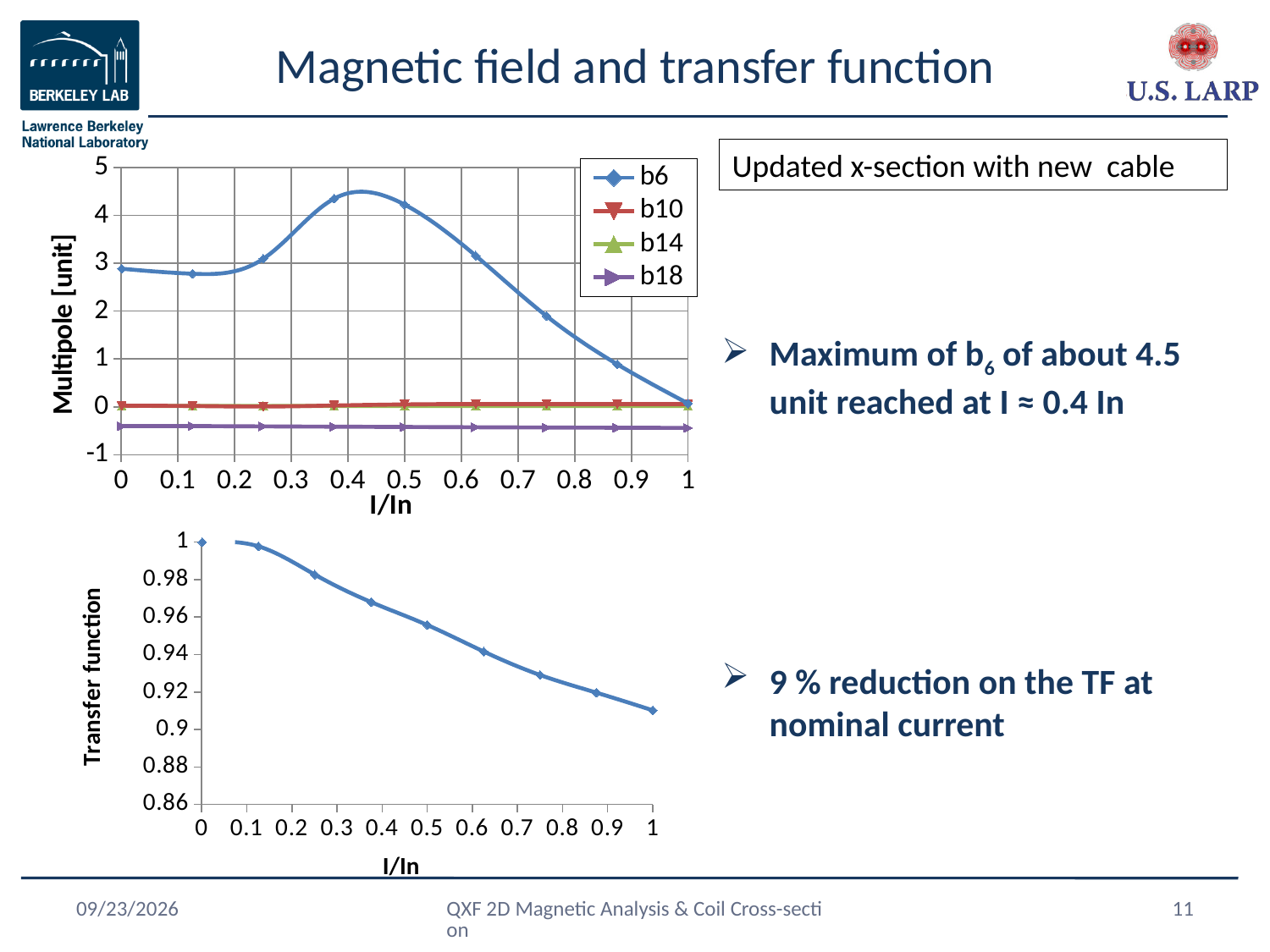
What type of chart is the bottom chart (Transfer function vs I/In)? line chart What type of chart is the top chart (Multipole vs I/In)? line chart In the top chart, does b6 rise or fall between I/In = 0.4 and I/In = 1? fall In the top chart, is the value of b6 at I/In = 1 greater or less than 1? less In the bottom chart, is the transfer function at I/In = 1 greater or less than 0.92? less What is the y-axis label of the top chart? Multipole [unit] In the bottom chart, does the transfer function rise or fall as I/In increases? fall In the top chart, is the value of b18 greater or less than 0? less How many series does the legend of the top chart list? 4 Which series in the top chart reaches the highest value? b6 Which series in the top chart has the lowest values across the I/In range? b18